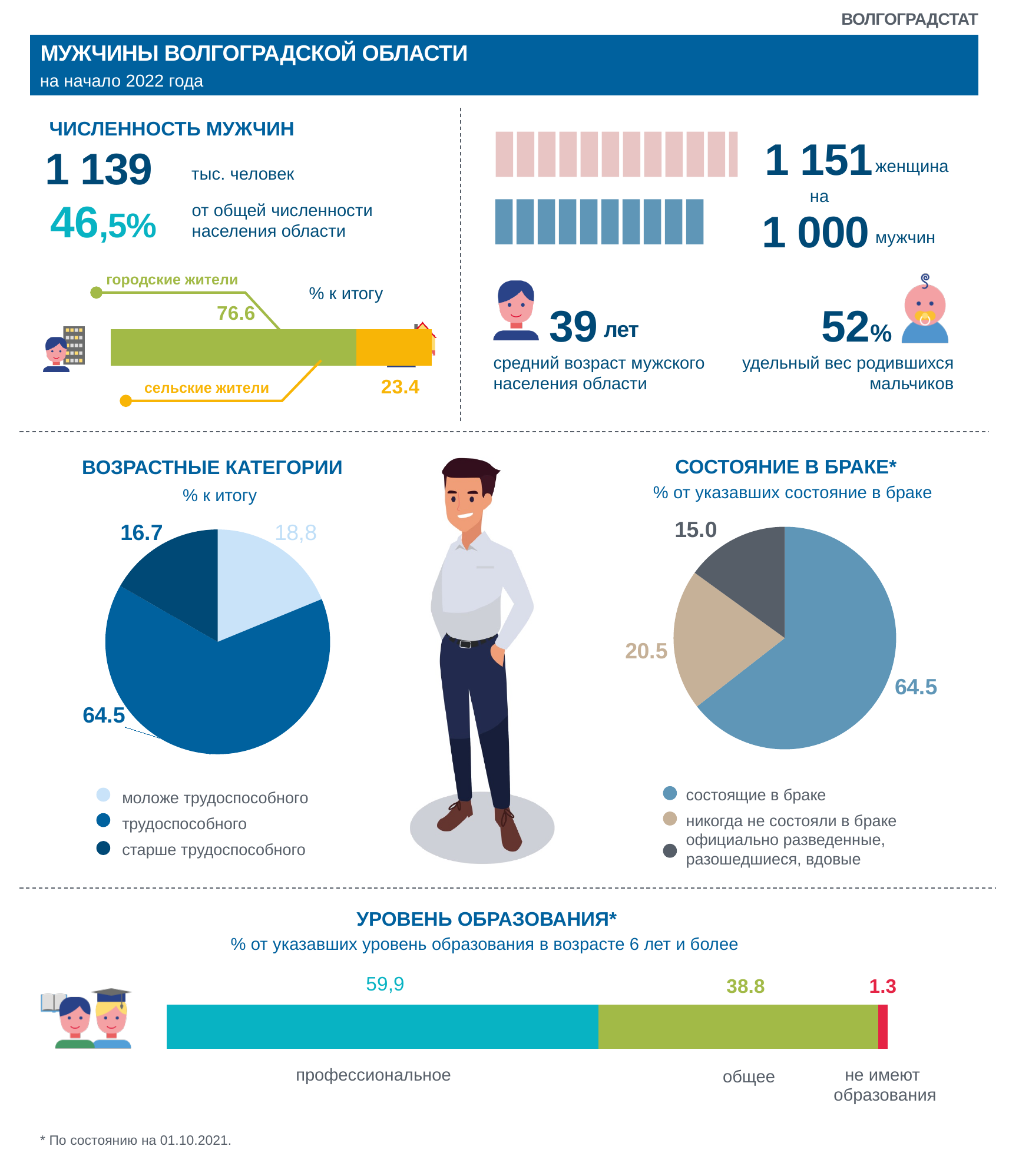
In the 'СОСТОЯНИЕ В БРАКЕ' pie chart, what is the value for 'никогда не состояли в браке'? 20.5 In the 'ВОЗРАСТНЫЕ КАТЕГОРИИ' pie chart, what is the value for 'трудоспособного'? 64.5 In the 'СОСТОЯНИЕ В БРАКЕ' pie chart, what is the difference between 'состоящие в браке' and 'официально разведенные, разошедшиеся, вдовые'? 49.5 In the 'ЧИСЛЕННОСТЬ МУЖЧИН' bar chart, what is the value for 'сельские жители'? 23.4 In the 'ВОЗРАСТНЫЕ КАТЕГОРИИ' pie chart, what is the value for 'моложе трудоспособного'? 18,8 In the 'ЧИСЛЕННОСТЬ МУЖЧИН' bar chart, which is larger: 'городские жители' or 'сельские жители'? городские жители In the 'ВОЗРАСТНЫЕ КАТЕГОРИИ' pie chart, which category has the smallest share? старше трудоспособного In the 'УРОВЕНЬ ОБРАЗОВАНИЯ' bar chart, which category has the lowest value? не имеют образования What kind of chart is used for 'СОСТОЯНИЕ В БРАКЕ'? pie chart In the 'ВОЗРАСТНЫЕ КАТЕГОРИИ' pie chart, how many categories does the legend list? 3 In the 'СОСТОЯНИЕ В БРАКЕ' pie chart, which category has the largest share? состоящие в браке In the 'УРОВЕНЬ ОБРАЗОВАНИЯ' bar chart, what is the value for 'общее'? 38.8